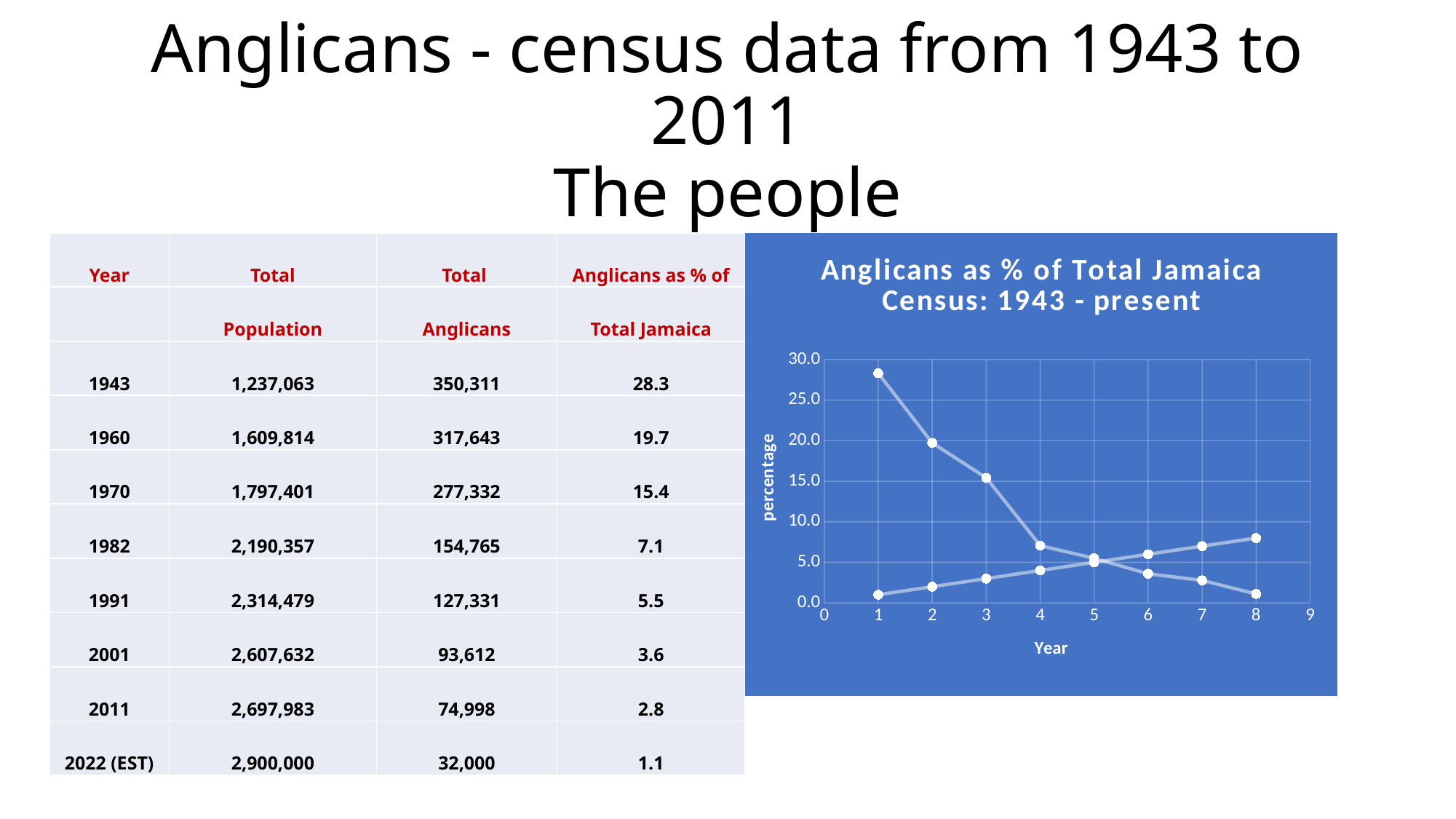
At Year 8, which line has the higher value: the rising line or the falling line? the rising line Is the value of the falling line at Year 1 greater or less than 25.0? greater Does the line that starts highest at Year 1 rise or fall as the Year increases? fall What is the label on the vertical axis of the chart? percentage How many data points does each line on the chart have? 8 Is the value of the falling line at Year 4 greater or less than 10.0? less At which Year does the falling line reach its highest value? 1 At which Year does the falling line reach its lowest value? 8 What kind of chart is shown on the slide? line chart Is the value of the falling line at Year 8 greater or less than 5.0? less What is the title of the chart? Anglicans as % of Total Jamaica Census: 1943 - present How many lines are plotted on the chart? 2